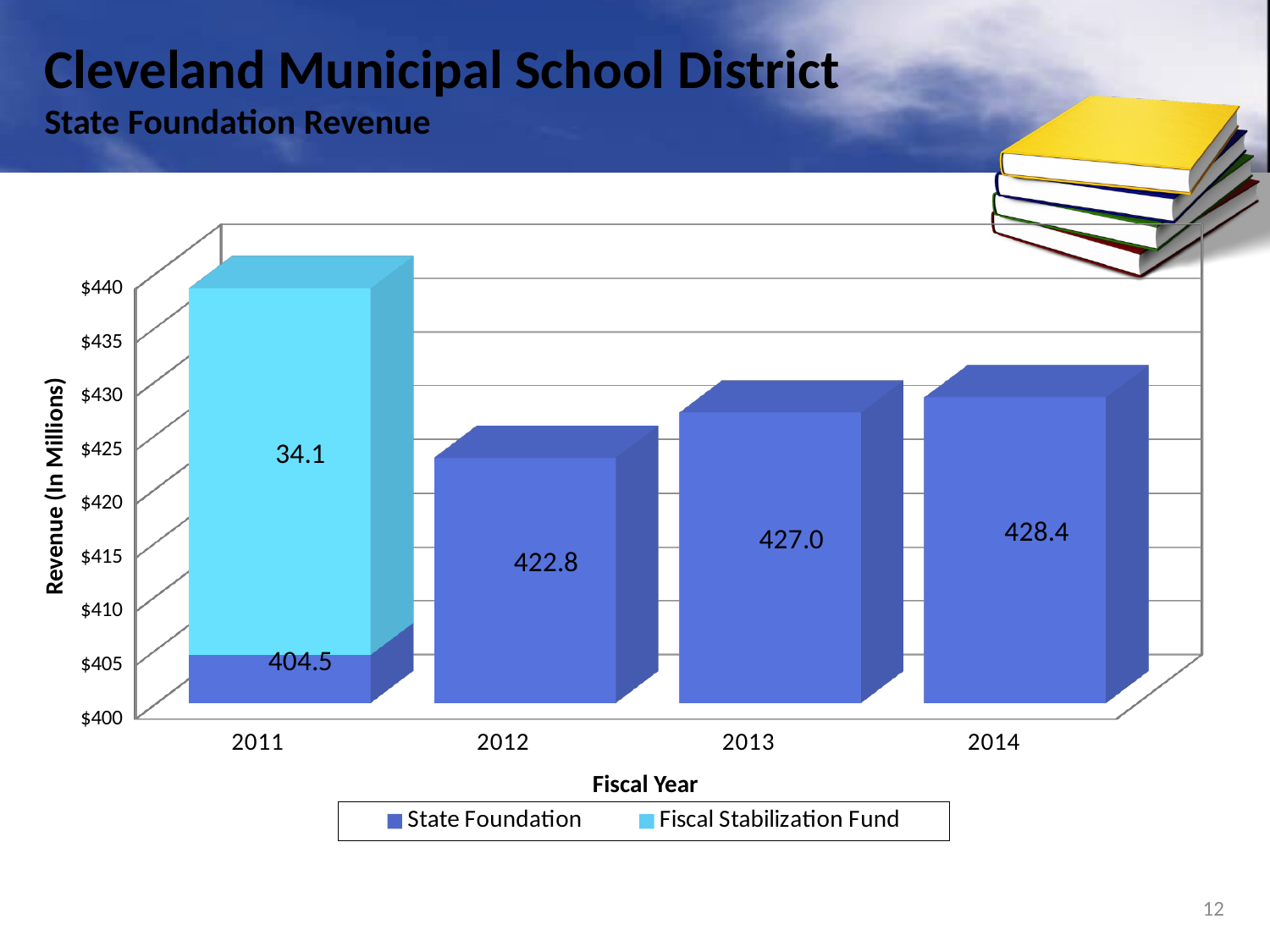
How many fiscal years are shown on the x axis? 4 How many series does the legend list? 2 What is the Fiscal Stabilization Fund value for fiscal year 2011? 34.1 Does the State Foundation value rise or fall from 2011 to 2014? rise What is the State Foundation value for fiscal year 2012? 422.8 What kind of chart is shown on the slide? bar chart Which fiscal year has the lowest State Foundation value? 2011 What is the State Foundation value for fiscal year 2014? 428.4 Is the State Foundation value for 2013 larger or smaller than the value for 2012? larger Which fiscal year has the highest State Foundation value? 2014 What is the difference between the State Foundation values for 2014 and 2013? 1.4 What is the total of the stacked bar for fiscal year 2011? 438.6